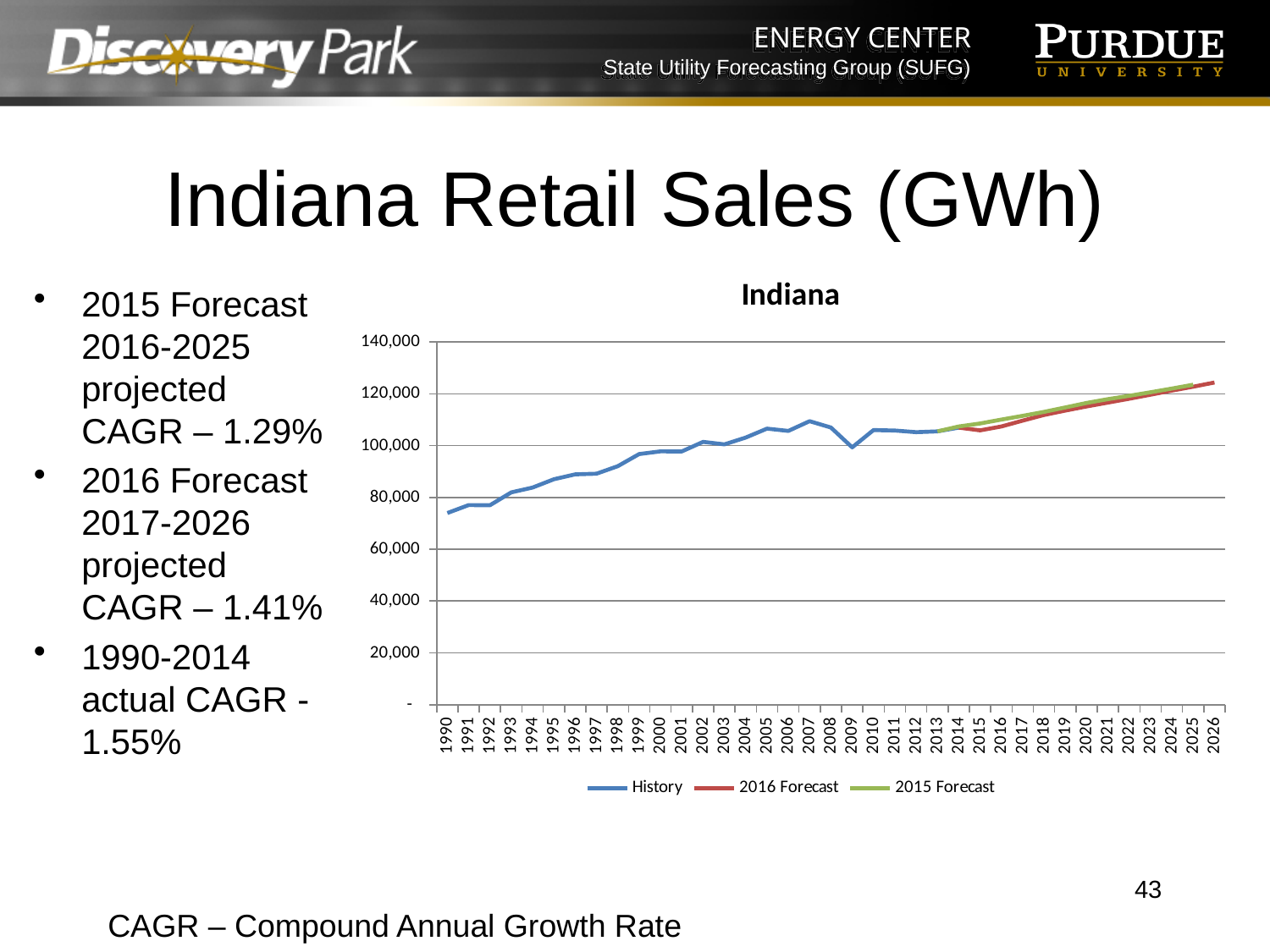
Is the forecast value for 2020 greater or less than 100,000? greater Is the History value for 1995 greater or less than 100,000? less What kind of chart is shown on the slide? line chart What is the title of the chart? Indiana Is the History value for 2007 greater or less than 100,000? greater Which is larger, the value for 1990 or the value for 2026? 2026 Do the values in the Indiana chart generally rise or fall from 1990 to 2026? rise Which year has the lowest History value in the Indiana chart? 1990 How many series does the legend of the Indiana chart list? 3 Which series is drawn in red in the Indiana chart? 2016 Forecast